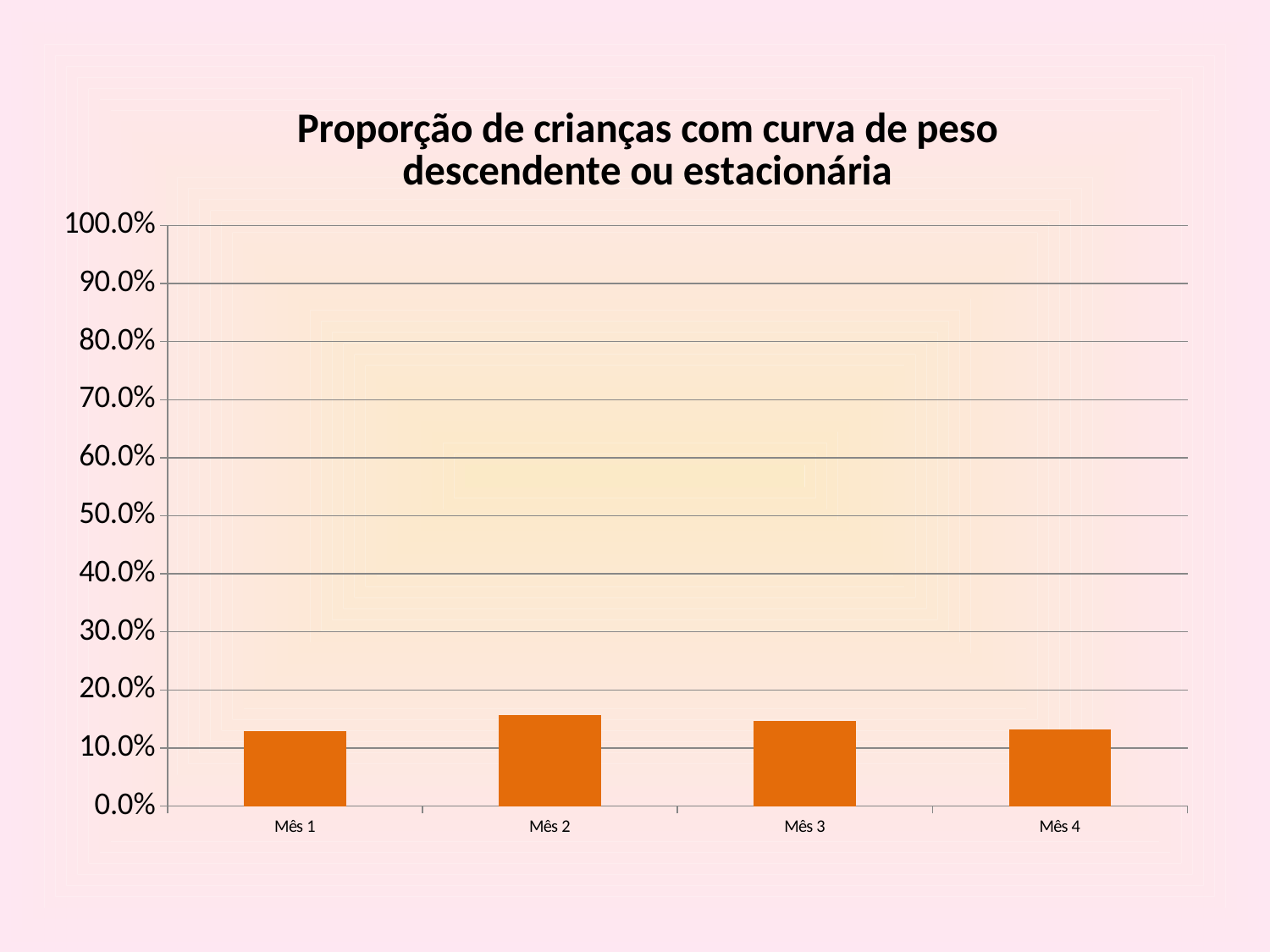
Which is larger, the value for Mês 2 or the value for Mês 1? Mês 2 What is the highest value shown on the y axis of the chart? 100.0% How many categories are shown on the x axis of the chart? 4 Is the value for Mês 4 greater or less than 20.0%? less What kind of chart is shown on the slide? bar chart Which is larger, the value for Mês 3 or the value for Mês 4? Mês 3 Is the value for Mês 3 greater or less than 10.0%? greater Is the value for Mês 1 greater or less than 10.0%? greater Which month has the highest bar in the chart? Mês 2 What is the title of the chart? Proporção de crianças com curva de peso descendente ou estacionária